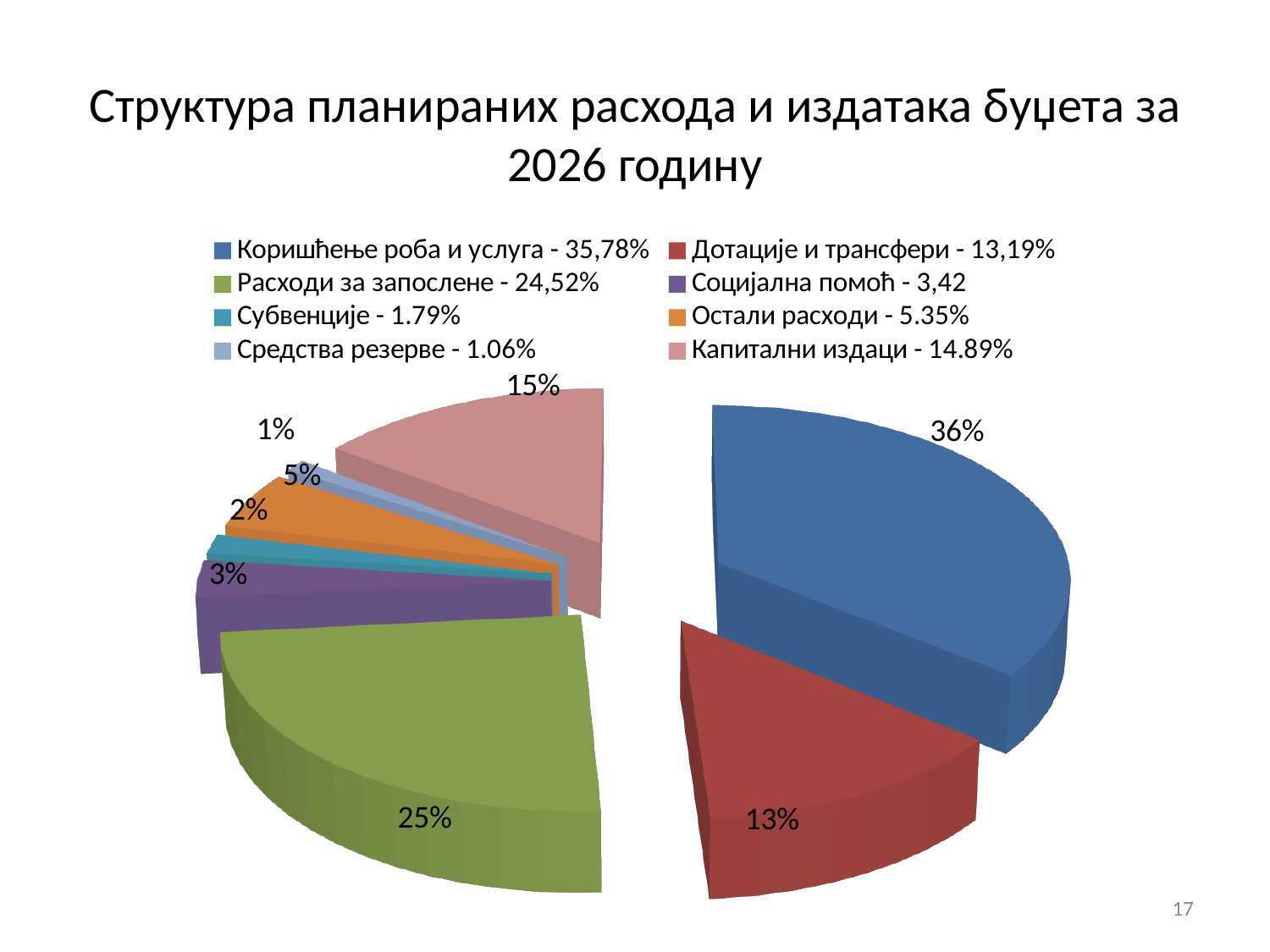
What percentage label is shown on the slice for Расходи за запослене? 25% What is the title of the chart on the slide? Структура планираних расхода и издатака буџета за 2026 годину Which slice is larger: Расходи за запослене or Капитални издаци? Расходи за запослене What kind of chart is shown on the slide? pie chart What is the difference in percentage points between the slice labels for Коришћење роба и услуга (36%) and Дотације и трансфери (13%)? 23 Which category has the smallest slice of the pie? Средства резерве Which category has the largest slice of the pie? Коришћење роба и услуга What share of the pie does Капитални издаци represent, according to its data label? 15% What percentage label is shown on the slice for Коришћење роба и услуга? 36% What percentage label is shown on the slice for Дотације и трансфери? 13% How many categories (slices) does the pie chart have? 8 What value does the legend give for Остали расходи? 5.35%